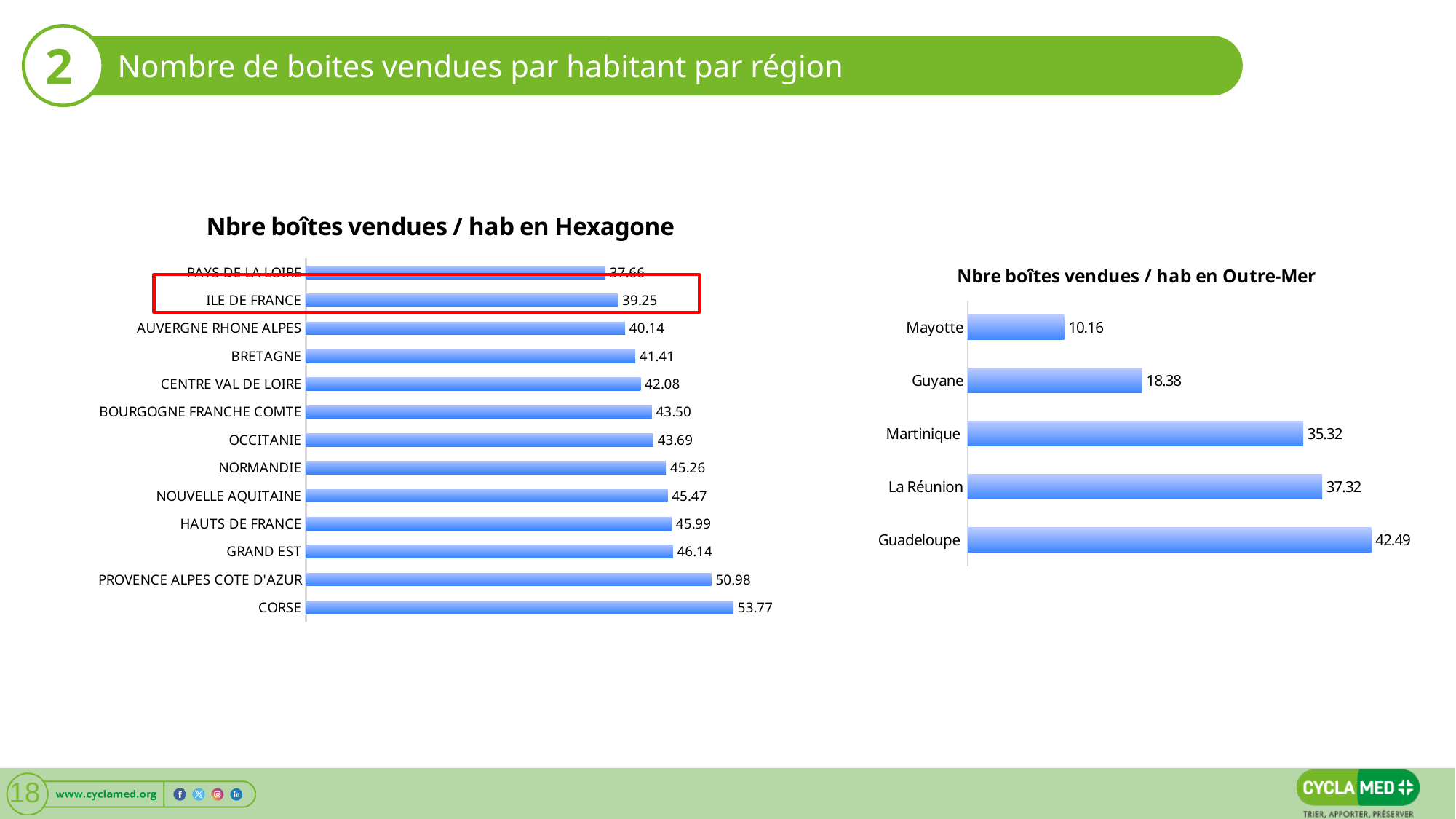
In the chart 'Nbre boîtes vendues / hab en Hexagone', how many regions are shown? 13 In the chart 'Nbre boîtes vendues / hab en Outre-Mer', which territory has the highest value? Guadeloupe In the chart 'Nbre boîtes vendues / hab en Hexagone', which region has the highest value? CORSE In the chart 'Nbre boîtes vendues / hab en Hexagone', what is the value for CORSE? 53.77 In the chart 'Nbre boîtes vendues / hab en Hexagone', what is the difference between CORSE and PROVENCE ALPES COTE D'AZUR? 2.79 In the chart 'Nbre boîtes vendues / hab en Outre-Mer', how many territories are shown? 5 In the chart 'Nbre boîtes vendues / hab en Hexagone', what is the value for ILE DE FRANCE? 39.25 In the chart 'Nbre boîtes vendues / hab en Outre-Mer', what is the value for Mayotte? 10.16 What type of chart is 'Nbre boîtes vendues / hab en Outre-Mer'? Bar chart In the chart 'Nbre boîtes vendues / hab en Outre-Mer', what is the difference between Guadeloupe and Guyane? 24.11 In the chart 'Nbre boîtes vendues / hab en Hexagone', which region has the lowest value? PAYS DE LA LOIRE In the chart 'Nbre boîtes vendues / hab en Outre-Mer', which is larger, Martinique or La Réunion? La Réunion